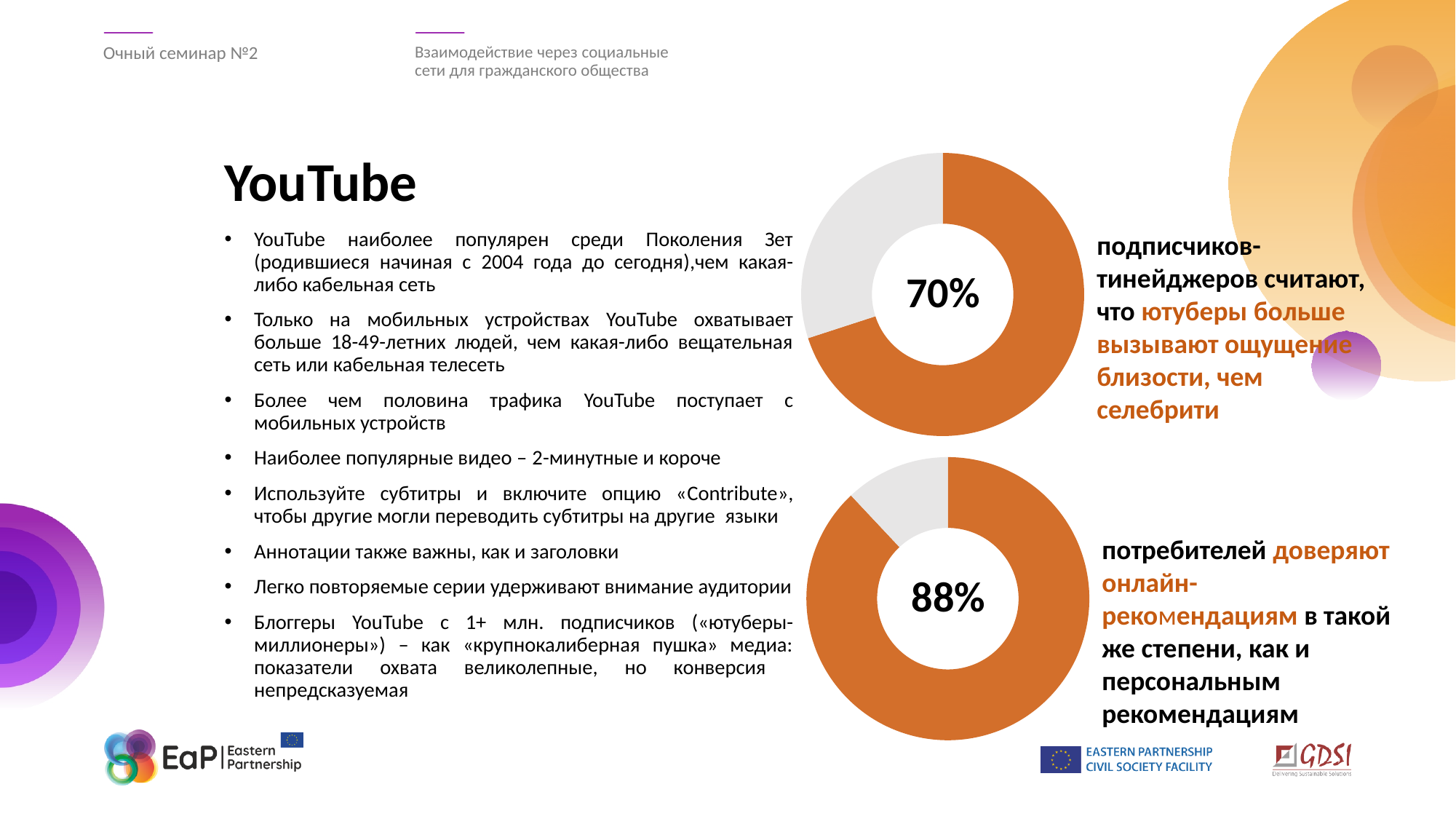
Which donut chart shows the larger percentage, the upper one or the lower one? The lower one In the upper donut chart, is the orange segment larger or smaller than the grey segment? Larger What is the difference between the percentage in the lower donut chart and the percentage in the upper donut chart? 18% Is the value shown in the upper donut chart greater or less than 50%? greater What percentage is shown in the centre of the lower donut chart? 88% How many donut charts are on the slide? 2 What percentage is shown in the centre of the upper donut chart? 70% What kind of chart is the upper chart on the right side of the slide? Donut chart In the upper donut chart, what share of the ring is filled with orange? 70% In the lower donut chart, what share of the ring is filled with orange? 88% What kind of chart is the lower chart on the right side of the slide? Donut chart What colour is the filled (highlighted) segment in both donut charts? Orange